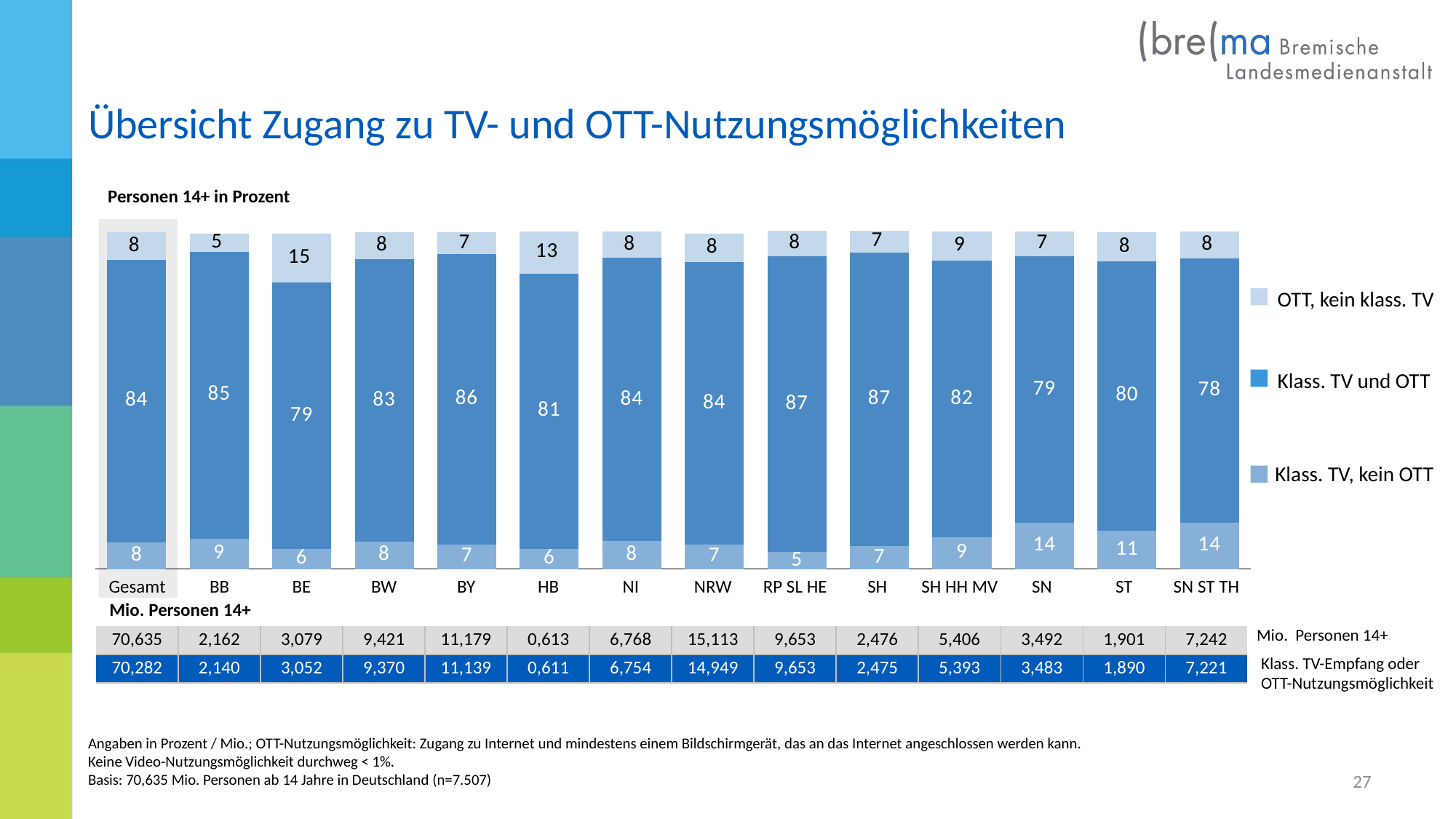
Which category has the highest value for "OTT, kein klass. TV"? BE What is the value of "Klass. TV, kein OTT" for ST? 11 Which category has the lowest value for "OTT, kein klass. TV"? BB What is the value of "Klass. TV und OTT" for Gesamt? 84 What kind of chart is shown on the slide? Stacked bar chart Which category has the lowest value for "Klass. TV und OTT"? SN ST TH Which is larger, the "Klass. TV, kein OTT" value for SN or for BB? SN What is the total of the stacked bar for HB? 100 What is the difference between the "Klass. TV und OTT" values for BY and HB? 5 How many series does the chart legend list? 3 How many categories are shown along the x axis of the chart? 14 What is the value of "OTT, kein klass. TV" for BE? 15